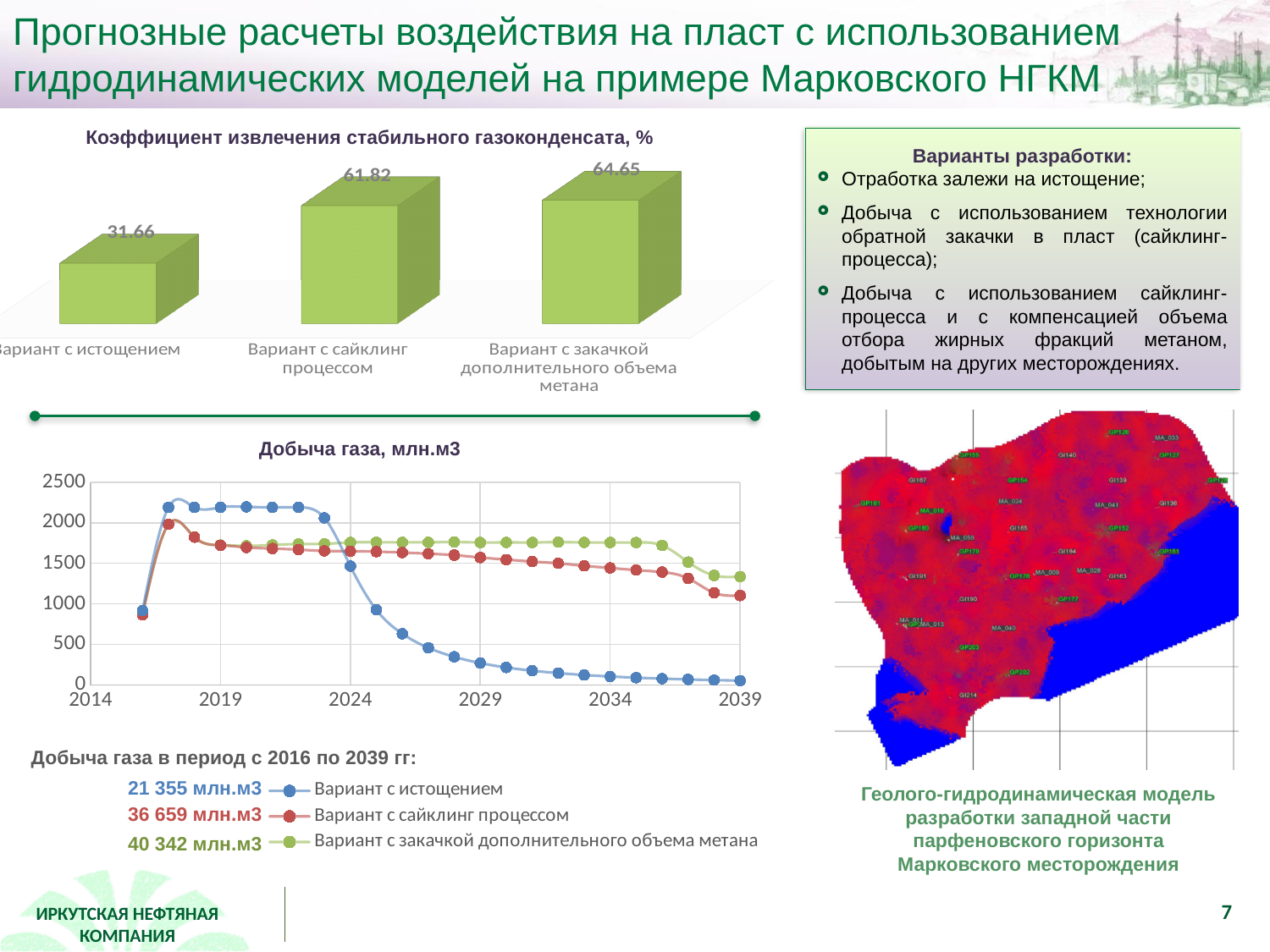
In the chart 'Добыча газа, млн.м3', how many series does the legend list? 3 In the chart 'Добыча газа, млн.м3', is the value for 'Вариант с истощением' in 2039 greater or less than 500? less In the chart 'Коэффициент извлечения стабильного газоконденсата, %', what is the value for 'Вариант с закачкой дополнительного объема метана'? 64.65 In the chart 'Коэффициент извлечения стабильного газоконденсата, %', what is the value for 'Вариант с сайклинг процессом'? 61.82 In the chart 'Коэффициент извлечения стабильного газоконденсата, %', which category has the lowest value? Вариант с истощением What kind of chart is 'Коэффициент извлечения стабильного газоконденсата, %'? Bar chart In the chart 'Коэффициент извлечения стабильного газоконденсата, %', how many categories are shown? 3 What kind of chart is 'Добыча газа, млн.м3'? Line chart In the chart 'Добыча газа, млн.м3', which series is higher in 2034: 'Вариант с закачкой дополнительного объема метана' or 'Вариант с истощением'? Вариант с закачкой дополнительного объема метана In the chart 'Коэффициент извлечения стабильного газоконденсата, %', which category has the highest value? Вариант с закачкой дополнительного объема метана In the chart 'Добыча газа, млн.м3', does the 'Вариант с истощением' series rise or fall between 2024 and 2039? Fall In the chart 'Коэффициент извлечения стабильного газоконденсата, %', what is the difference between 'Вариант с сайклинг процессом' and 'Вариант с истощением'? 30.16